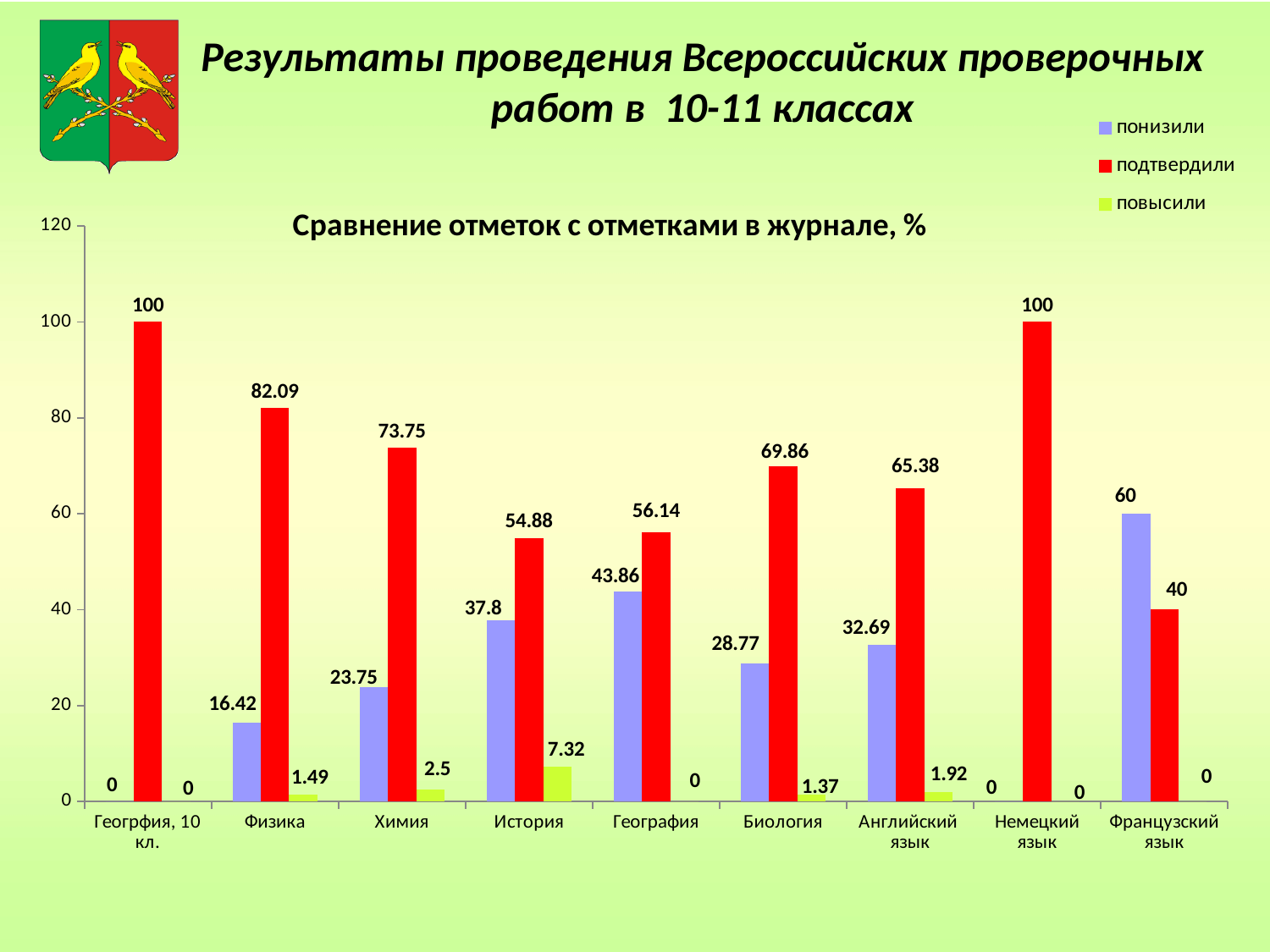
Which colour represents the 'подтвердили' series? red What is the difference between the 'подтвердили' and 'понизили' values for Французский язык? 20 Which category has the lowest value in the 'подтвердили' series? Французский язык What is the title of the chart? Сравнение отметок с отметками в журнале, % What is the value of the 'подтвердили' series for Физика? 82.09 What is the value of the 'повысили' series for Химия? 2.5 What is the value of the 'понизили' series for История? 37.8 What kind of chart is shown on the slide? bar chart Which is larger for Биология: the 'понизили' value or the 'подтвердили' value? подтвердили Which category has the highest value in the 'повысили' series? История How many series does the legend list? 3 How many categories are shown on the x axis? 9